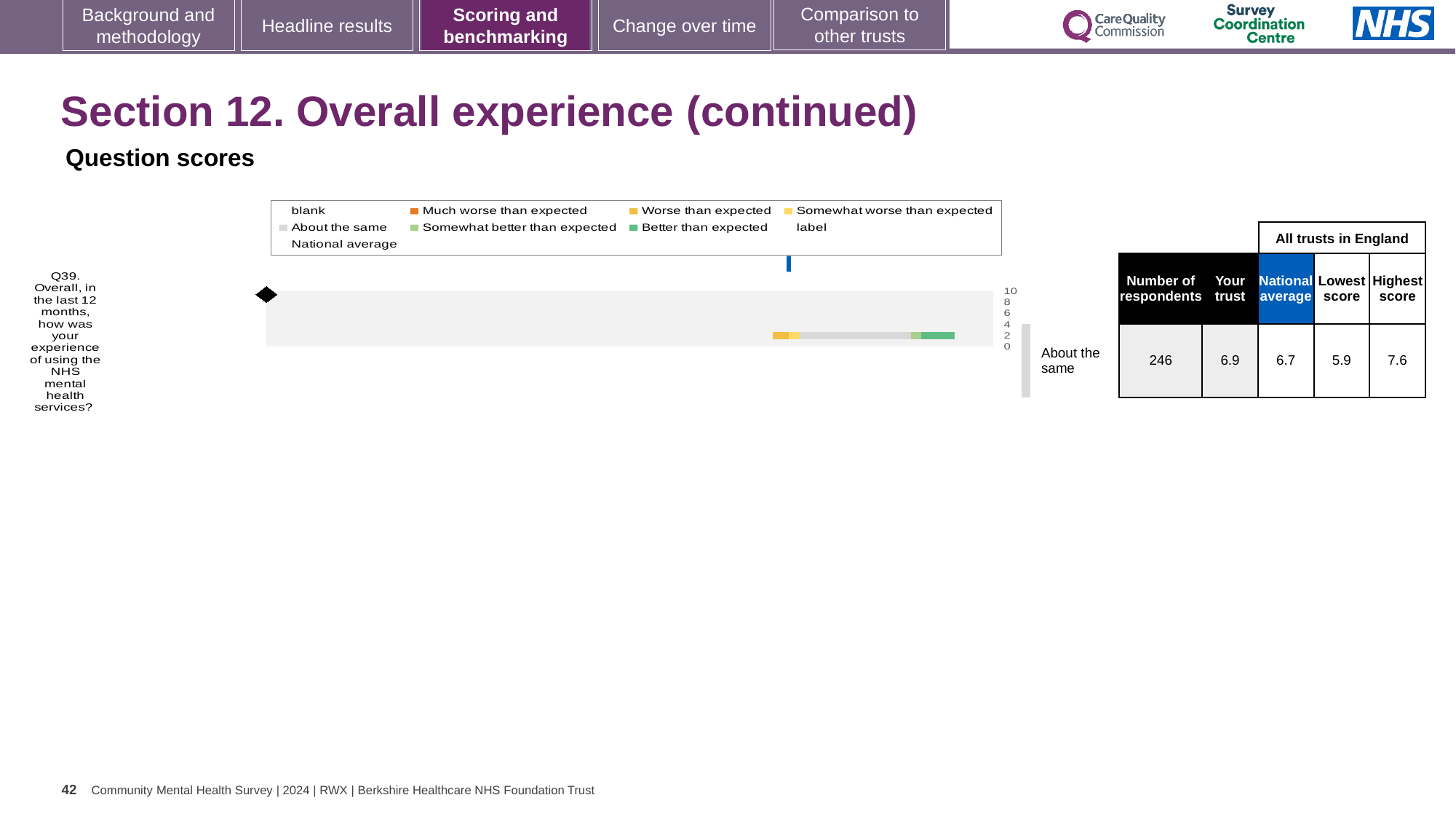
How many respondents answered Q39? 246 What is the score for 'Your trust' for Q39 (Overall, in the last 12 months, how was your experience of using the NHS mental health services?)? 6.9 What is the highest score among all trusts in England for Q39? 7.6 What is the difference between the trust's score and the national average for Q39? 0.2 How many questions are plotted on this chart? 1 Which is larger for Q39: the trust's score or the national average? Your trust What benchmarking category is the trust's Q39 score placed in? About the same What is the difference between the highest and lowest scores among all trusts in England for Q39? 1.7 What is the lowest score among all trusts in England for Q39? 5.9 What is the national average score shown for Q39? 6.7 What kind of chart is used to show the Q39 benchmarking result? Bar chart Which legend entry is shown in orange? Much worse than expected